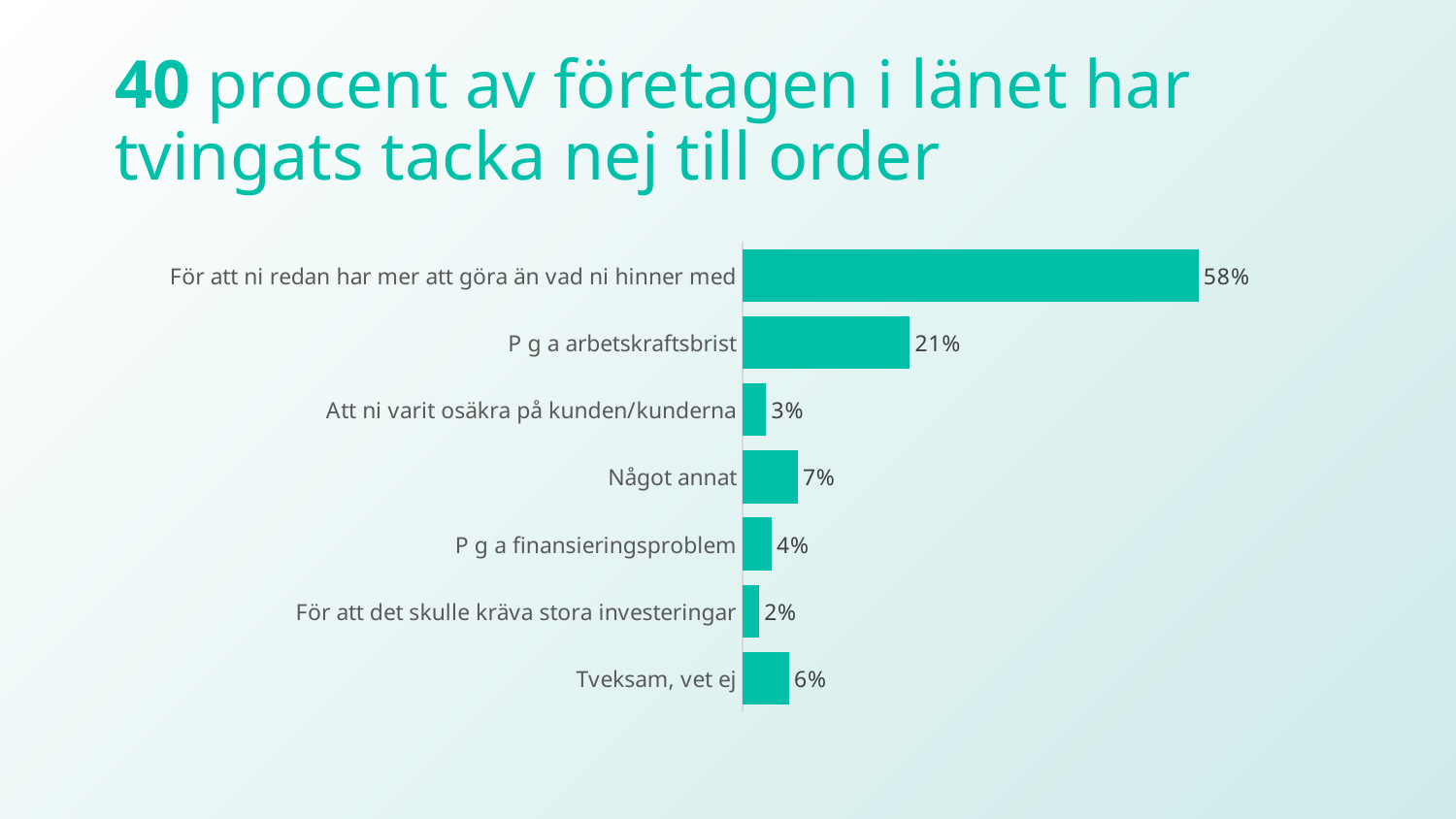
Which category has the lowest value? För att det skulle kräva stora investeringar What is the value for "Tveksam, vet ej"? 6% What is the difference between the values for "För att ni redan har mer att göra än vad ni hinner med" and "P g a arbetskraftsbrist"? 37% What is the value for "P g a arbetskraftsbrist"? 21% What is the value for "P g a finansieringsproblem"? 4% What is the title of the slide? 40 procent av företagen i länet har tvingats tacka nej till order What kind of chart is shown on the slide? Bar chart Which category has the highest value? För att ni redan har mer att göra än vad ni hinner med How many categories are shown in the chart? 7 What is the difference between the values for "Att ni varit osäkra på kunden/kunderna" and "För att det skulle kräva stora investeringar"? 1% Which is larger, the value for "Något annat" or the value for "Tveksam, vet ej"? Något annat What is the value for "Något annat"? 7%